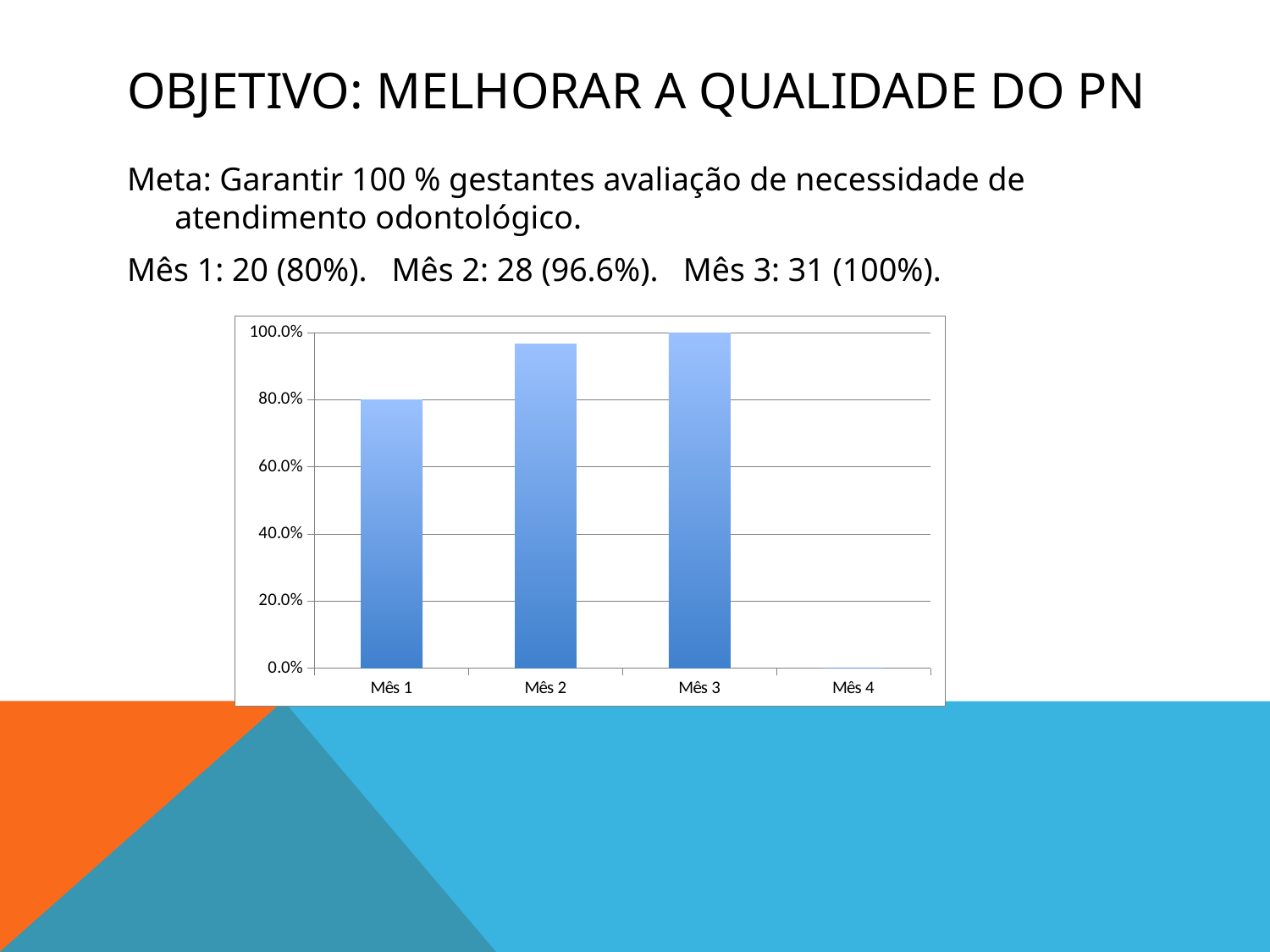
What is the value of the bar for Mês 3? 100.0% Which is larger, the value for Mês 1 or the value for Mês 2? Mês 2 Which of the plotted months has the lowest bar? Mês 1 Do the bar values rise or fall from Mês 1 to Mês 3? rise What kind of chart is shown on the slide? bar chart How many categories are labelled on the x axis of the chart? 4 What is the value of the bar for Mês 1? 80.0% Which month has the highest bar? Mês 3 How many bars are plotted in the chart? 3 Is the value for Mês 1 greater or less than 60.0%? greater Is the value for Mês 2 greater or less than 80.0%? greater What is the highest tick value shown on the y axis? 100.0%